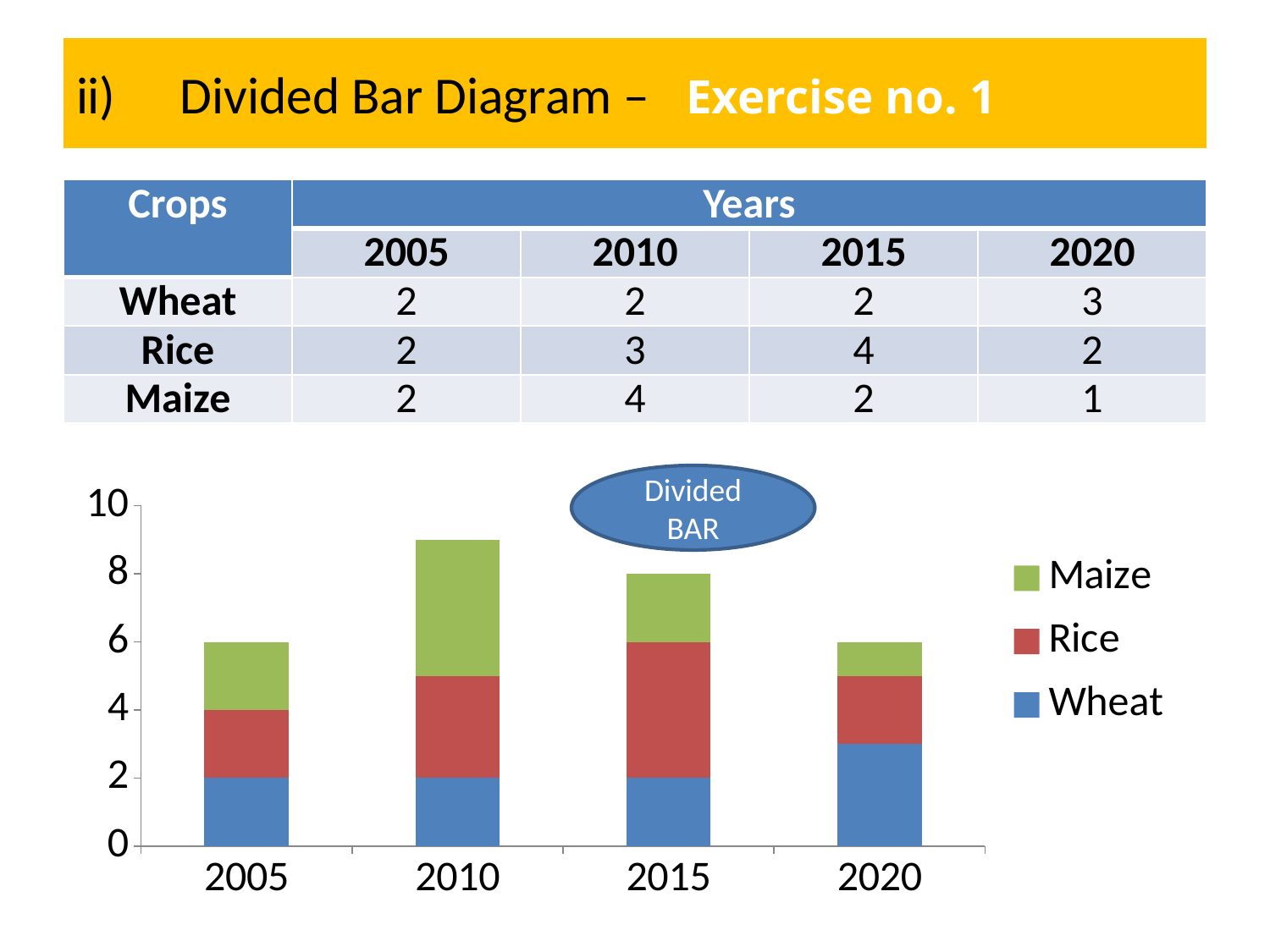
What is the value for Wheat in 2020? 3 Which year has the tallest stacked bar? 2010 Which colour represents Wheat in the chart legend? Blue What kind of chart is shown on the slide? Stacked bar chart What is the value for Maize in 2010? 4 How many series does the chart legend list? 3 What is the total height of the stacked bar for 2015? 8 How many years are shown along the x axis of the chart? 4 What is the total height of the stacked bar for 2010? 9 What is the value for Rice in 2015? 4 Which is larger, the Rice value in 2010 or the Rice value in 2020? Rice in 2010 What is the difference between the Maize values for 2010 and 2020? 3